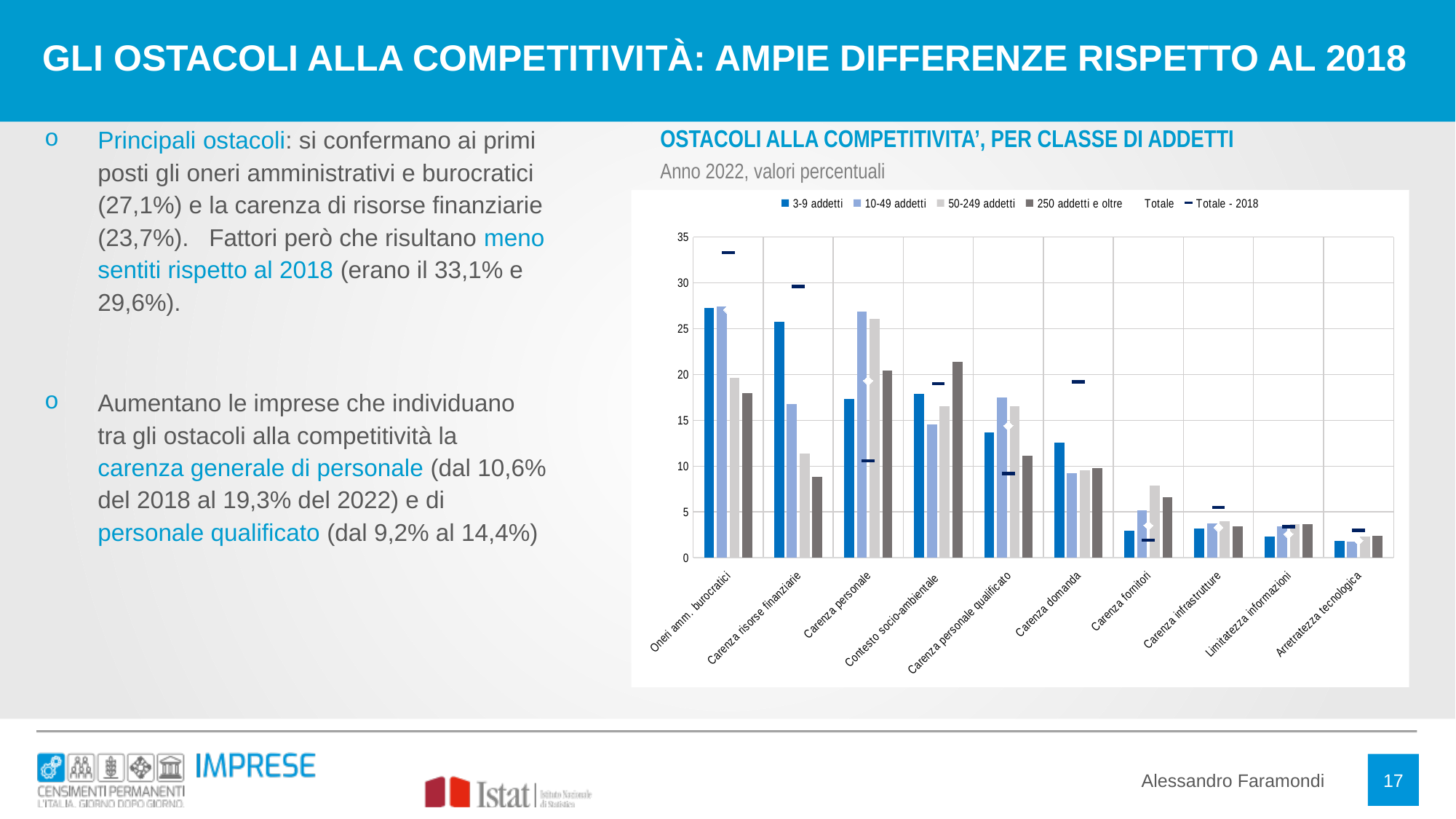
In Oneri amm. burocratici, which is larger: the value for 3-9 addetti or for 250 addetti e oltre? 3-9 addetti Is the value for 250 addetti e oltre in Carenza risorse finanziarie greater or less than 10? less Do the values for the 3-9 addetti series generally rise or fall from left to right across the categories? fall What kind of chart is shown on the slide? bar chart Is the Totale - 2018 marker for Oneri amm. burocratici greater or less than 30? greater Is the value for 3-9 addetti in Carenza domanda greater or less than 10? greater How many obstacle categories are shown on the x axis of the chart? 10 In Carenza personale, which is larger: the value for 3-9 addetti or for 10-49 addetti? 10-49 addetti For the 3-9 addetti series, which category has the highest value? Oneri amm. burocratici How many series does the chart legend list? 6 What is the title of the chart? OSTACOLI ALLA COMPETITIVITA', PER CLASSE DI ADDETTI